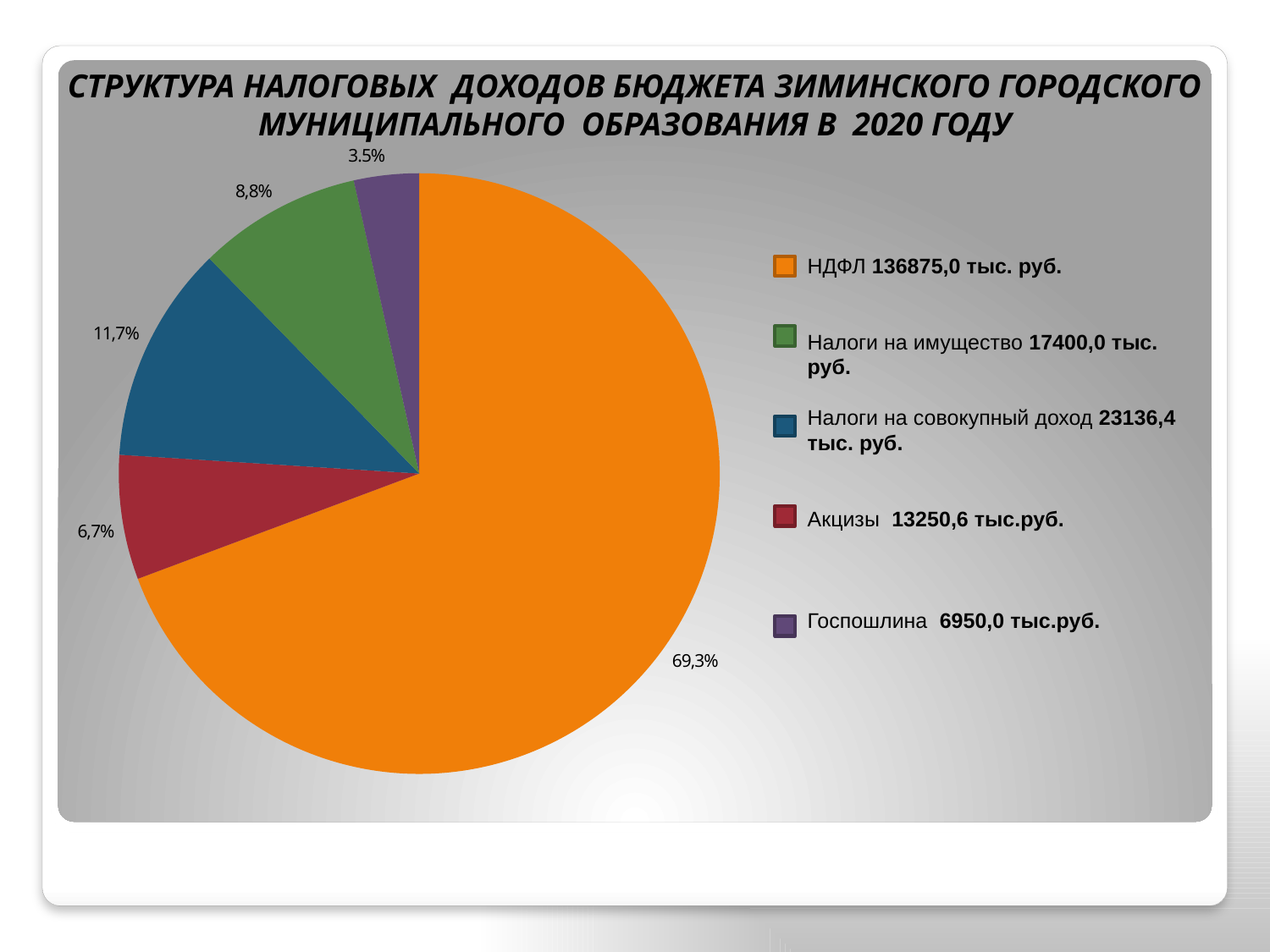
Which slice is larger: Налоги на имущество or Акцизы? Налоги на имущество What share of the pie does НДФЛ account for? 69,3% Which category has the largest slice of the pie? НДФЛ What share of the pie does Налоги на имущество account for? 8,8% How many categories does the pie chart show? 5 What colour is the slice for Налоги на совокупный доход? blue According to the legend, what is the amount for Акцизы? 13250,6 тыс.руб. What share of the pie does Госпошлина account for? 3.5% What kind of chart is shown on the slide? pie chart Which category has the smallest slice of the pie? Госпошлина